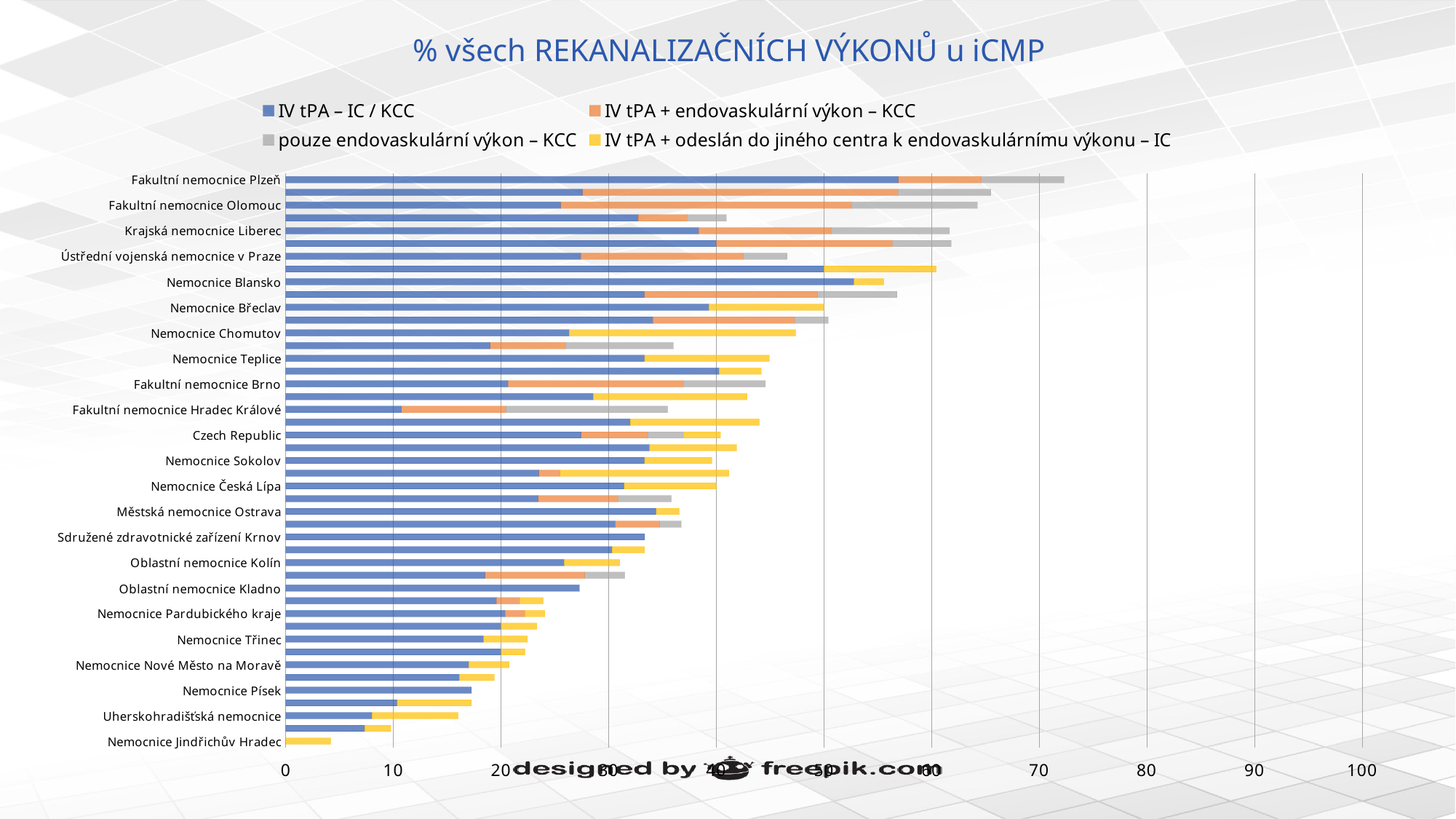
Is the total bar length for Nemocnice Blansko greater or less than 50? greater Is the total bar length for Nemocnice Jindřichův Hradec greater or less than 10? less Which labeled hospital has the shortest total bar? Nemocnice Jindřichův Hradec Which labeled hospital has the longest total bar? Fakultní nemocnice Plzeň Which series is shown in blue in the legend? IV tPA – IC / KCC Is the total bar length for Nemocnice Chomutov greater or less than 40? greater Which has the longer total bar, Nemocnice Blansko or Czech Republic? Nemocnice Blansko How many series does the legend list? 4 What kind of chart is shown on the slide? bar chart What is the title of the chart? % všech REKANALIZAČNÍCH VÝKONŮ u iCMP